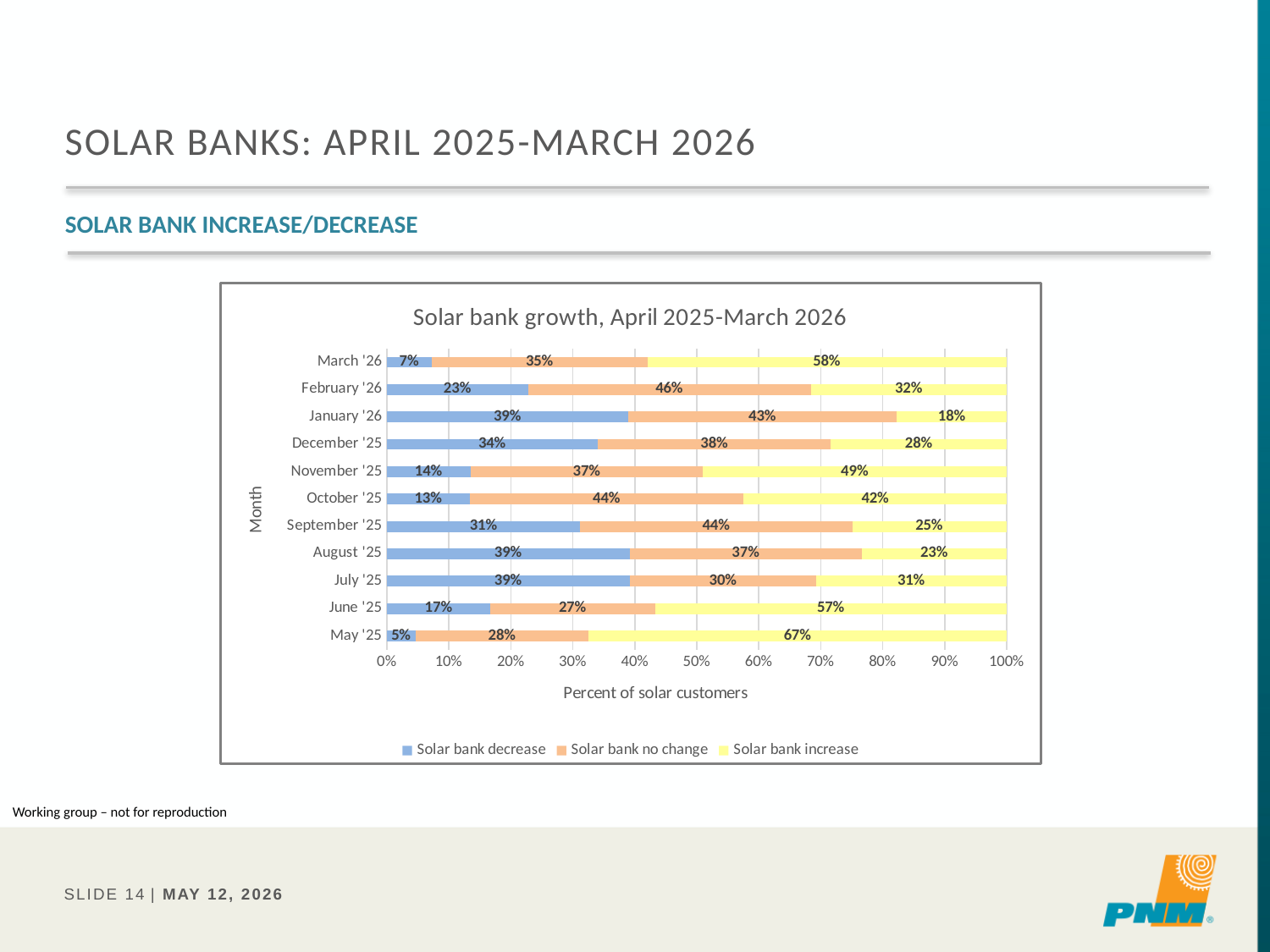
What is the title of the chart? Solar bank growth, April 2025-March 2026 What is the difference between the 'Solar bank increase' and 'Solar bank decrease' values for March '26? 51 percentage points What kind of chart is shown on the slide? Stacked bar chart Which month has the highest 'Solar bank increase' value? May '25 What is the 'Solar bank no change' value for February '26? 46% Which month has the lowest 'Solar bank increase' value? January '26 How many series does the legend list? 3 Which is larger for October '25: 'Solar bank no change' or 'Solar bank increase'? Solar bank no change Which month has the lowest 'Solar bank decrease' value? May '25 What percentage of solar customers had a solar bank increase in May '25? 67% How many months are shown on the chart? 11 What is the 'Solar bank decrease' value for January '26? 39%